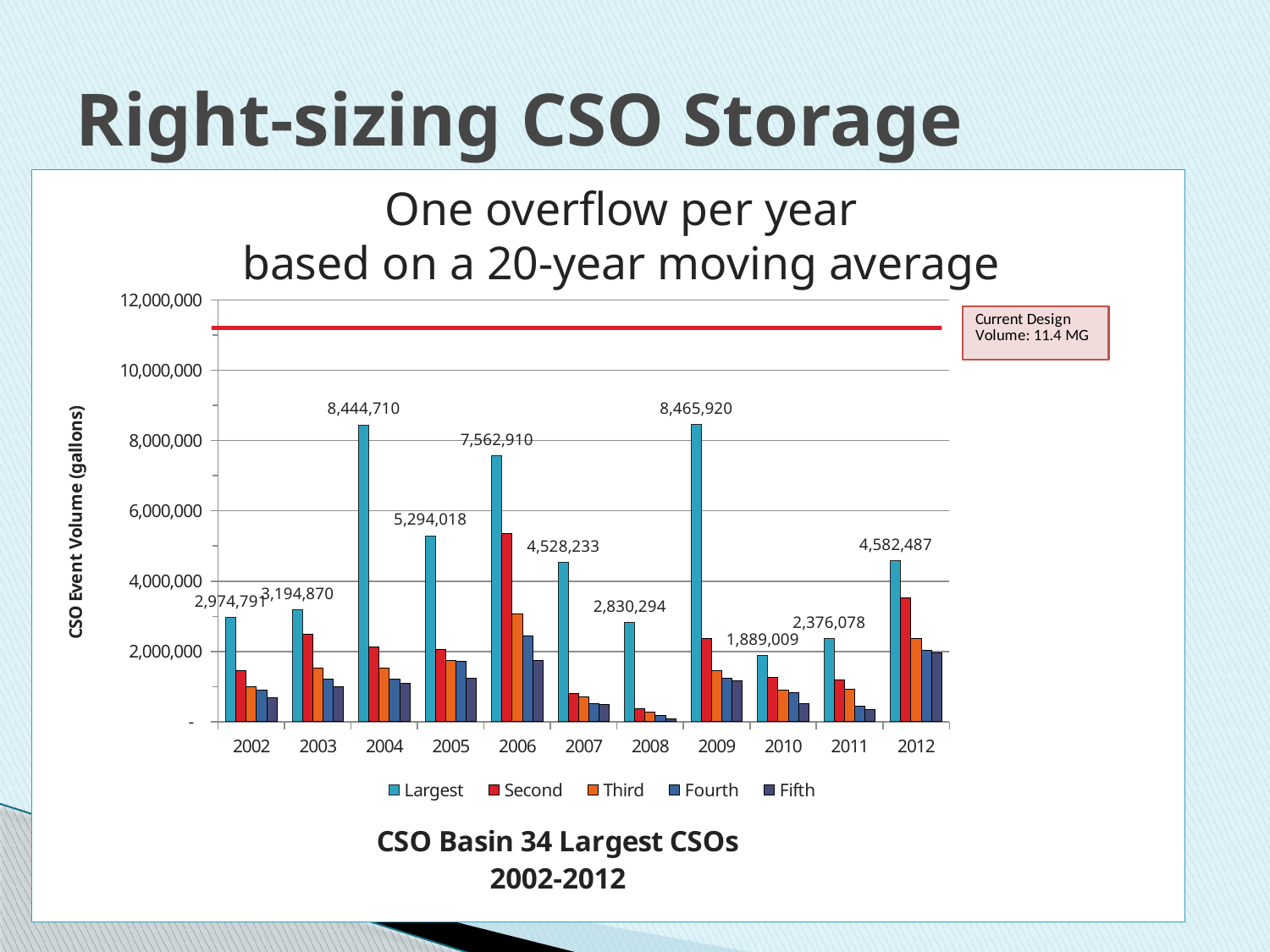
Which year has the lowest value for the Largest series? 2010 What is the value of the Largest series for 2004? 8,444,710 How many years are shown on the x axis? 11 What is the value of the Largest series for 2010? 1,889,009 Which is larger for the Largest series: 2005 or 2007? 2005 What is the value of the Largest series for 2012? 4,582,487 Is the value of the Second series for 2006 greater or less than 4,000,000? greater What type of chart is shown on the slide? Bar chart How many series does the legend list? 5 Which year has the highest value for the Largest series? 2009 What is the difference between the Largest series values for 2009 and 2004? 21,210 What is the value of the Largest series for 2009? 8,465,920